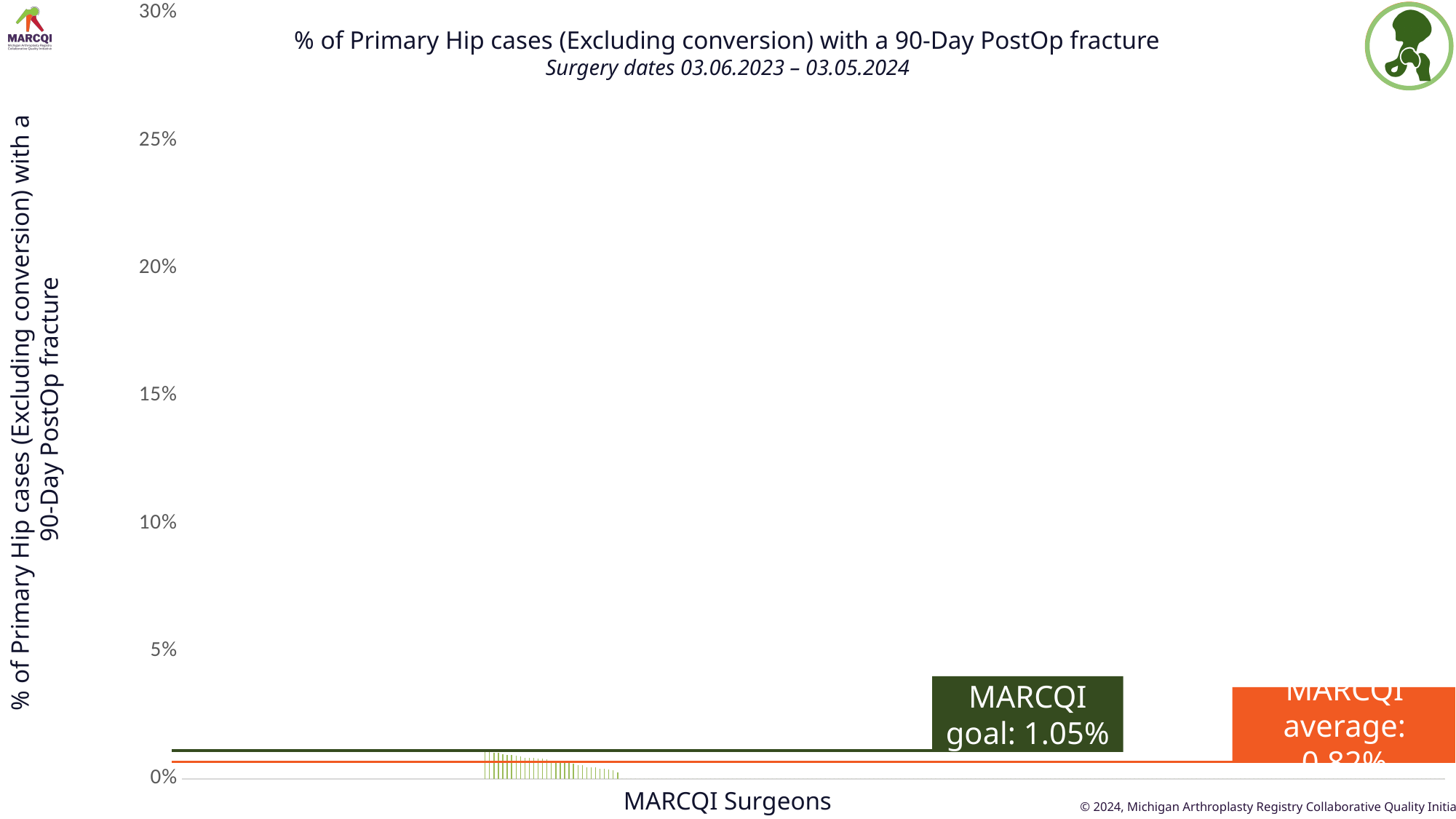
Is the MARCQI goal greater or less than 5%? less What range of surgery dates does the chart cover? 03.06.2023 – 03.05.2024 Is the MARCQI average greater or less than 5%? less What is the MARCQI goal value shown on the chart? 1.05% What is the difference between the MARCQI goal and the MARCQI average? 0.23% What is the MARCQI average value shown on the chart? 0.82% What is the highest value shown on the y axis of the chart? 30% Which is larger, the MARCQI goal or the MARCQI average? MARCQI goal What is the x-axis label of the chart? MARCQI Surgeons